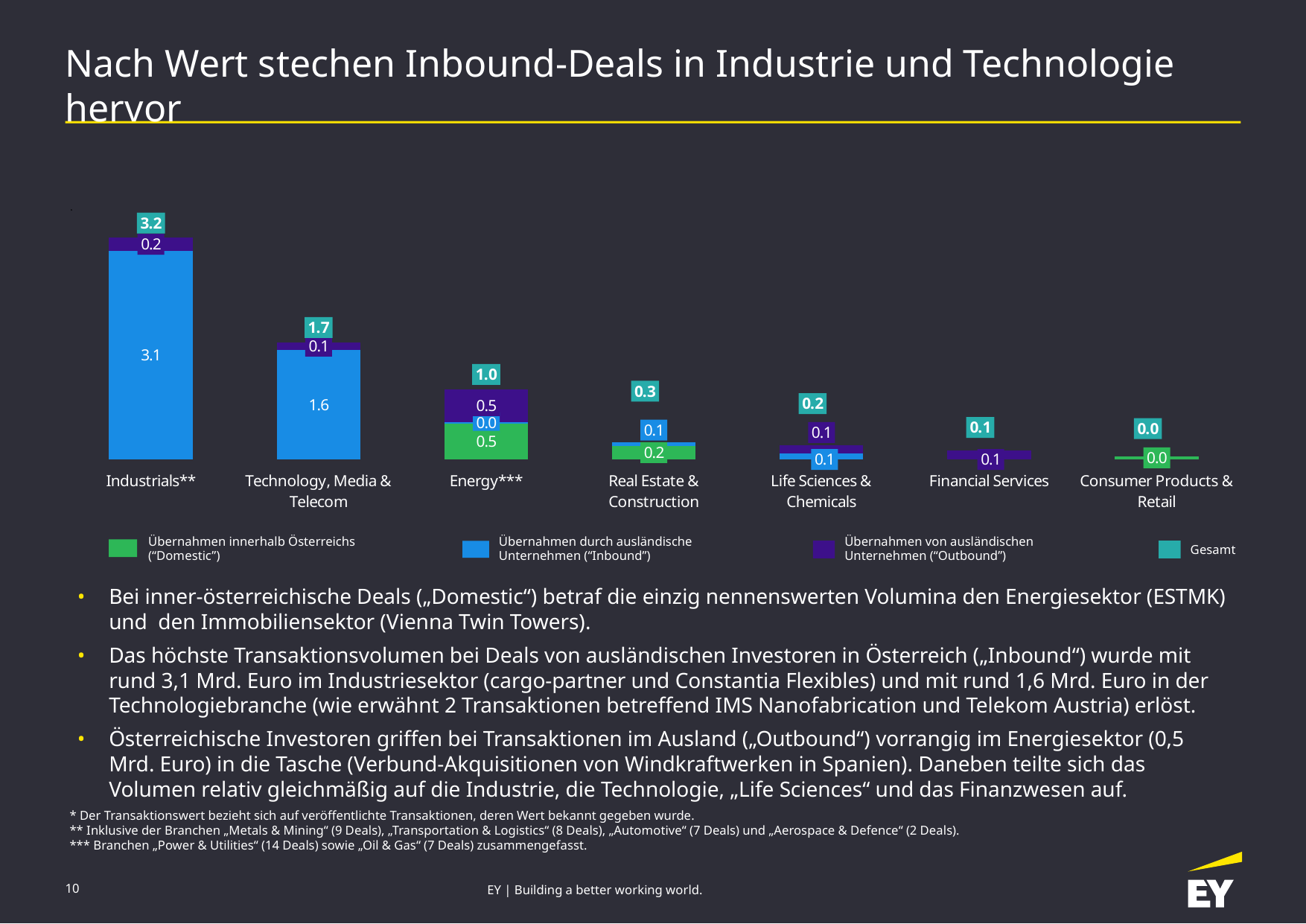
How many entries does the legend list? 4 What is the Outbound value for Energy***? 0.5 What is the Inbound value for Technology, Media & Telecom? 1.6 What kind of chart is shown on the slide? Stacked bar chart What is the difference between the Inbound values for Industrials** and Technology, Media & Telecom? 1.5 What is the Gesamt (total) value shown for Industrials**? 3.2 Which is larger: the Gesamt value for Energy*** or for Real Estate & Construction? Energy*** How many categories are shown on the x axis? 7 Which category has the lowest Gesamt (total) value? Consumer Products & Retail Do the Gesamt (total) values rise or fall from left to right along the x axis? Fall What is the Domestic value for Real Estate & Construction? 0.2 Which category has the highest Gesamt (total) value? Industrials**